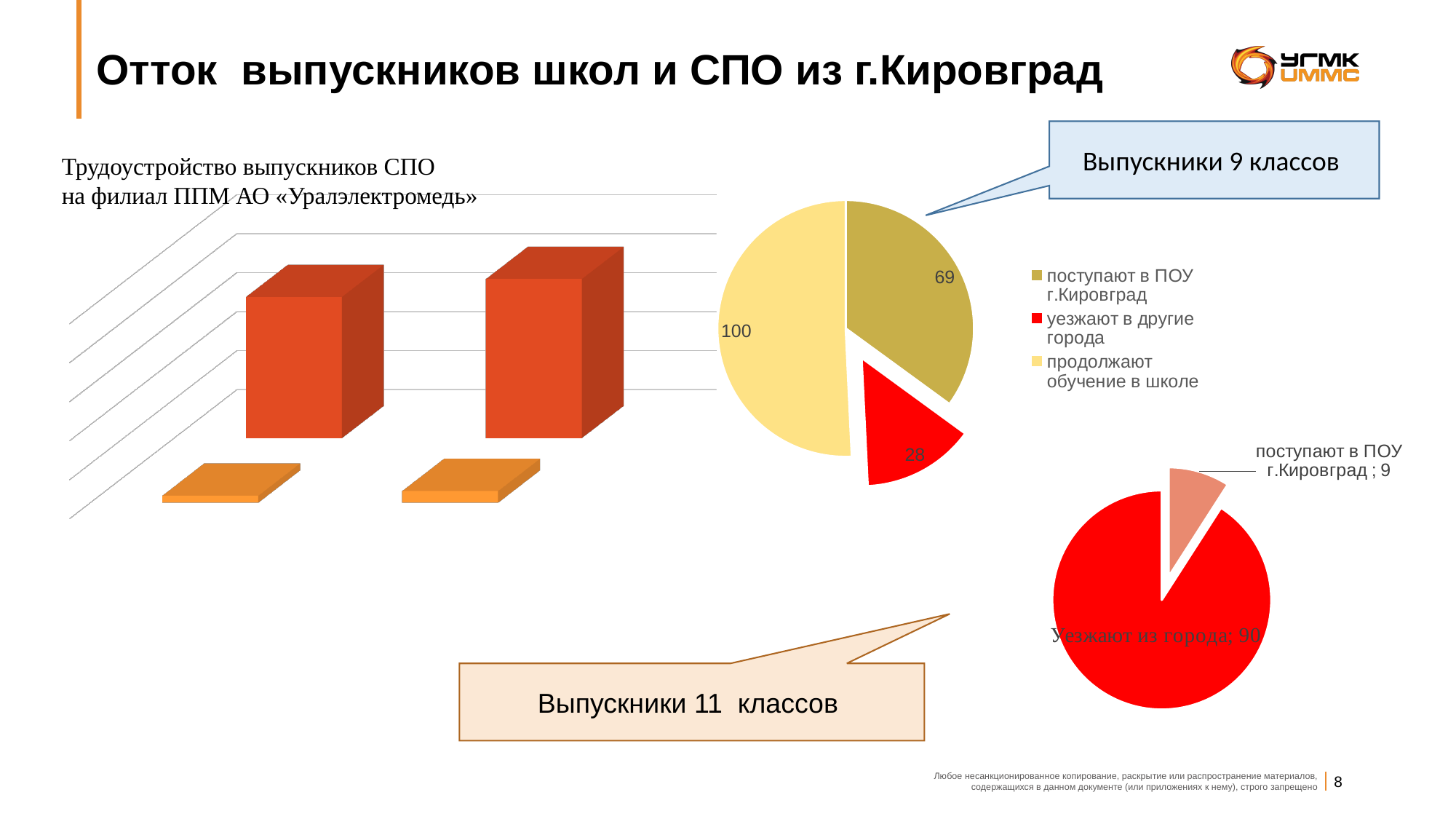
On the pie chart for 'Выпускники 9 классов', what is the value for 'поступают в ПОУ г.Кировград'? 69 What kind of chart is the one on the left titled 'Трудоустройство выпускников СПО на филиал ППМ АО «Уралэлектромедь»'? bar chart On the pie chart for 'Выпускники 9 классов', how many entries does the legend list? 3 On the pie chart for 'Выпускники 9 классов', what is the difference between 'продолжают обучение в школе' and 'уезжают в другие города'? 72 On the pie chart for 'Выпускники 9 классов', which category has the smallest value? уезжают в другие города On the pie chart for 'Выпускники 11 классов', what is the value for 'поступают в ПОУ г.Кировград'? 9 On the pie chart for 'Выпускники 9 классов', what is the value for 'уезжают в другие города'? 28 On the pie chart for 'Выпускники 11 классов', what is the value for 'Уезжают из города'? 90 On the pie chart for 'Выпускники 11 классов', what is the difference between 'Уезжают из города' and 'поступают в ПОУ г.Кировград'? 81 On the pie chart for 'Выпускники 9 классов', what is the value for 'продолжают обучение в школе'? 100 On the pie chart for 'Выпускники 9 классов', which category has the largest value? продолжают обучение в школе On the pie chart for 'Выпускники 11 классов', which is larger: 'Уезжают из города' or 'поступают в ПОУ г.Кировград'? Уезжают из города